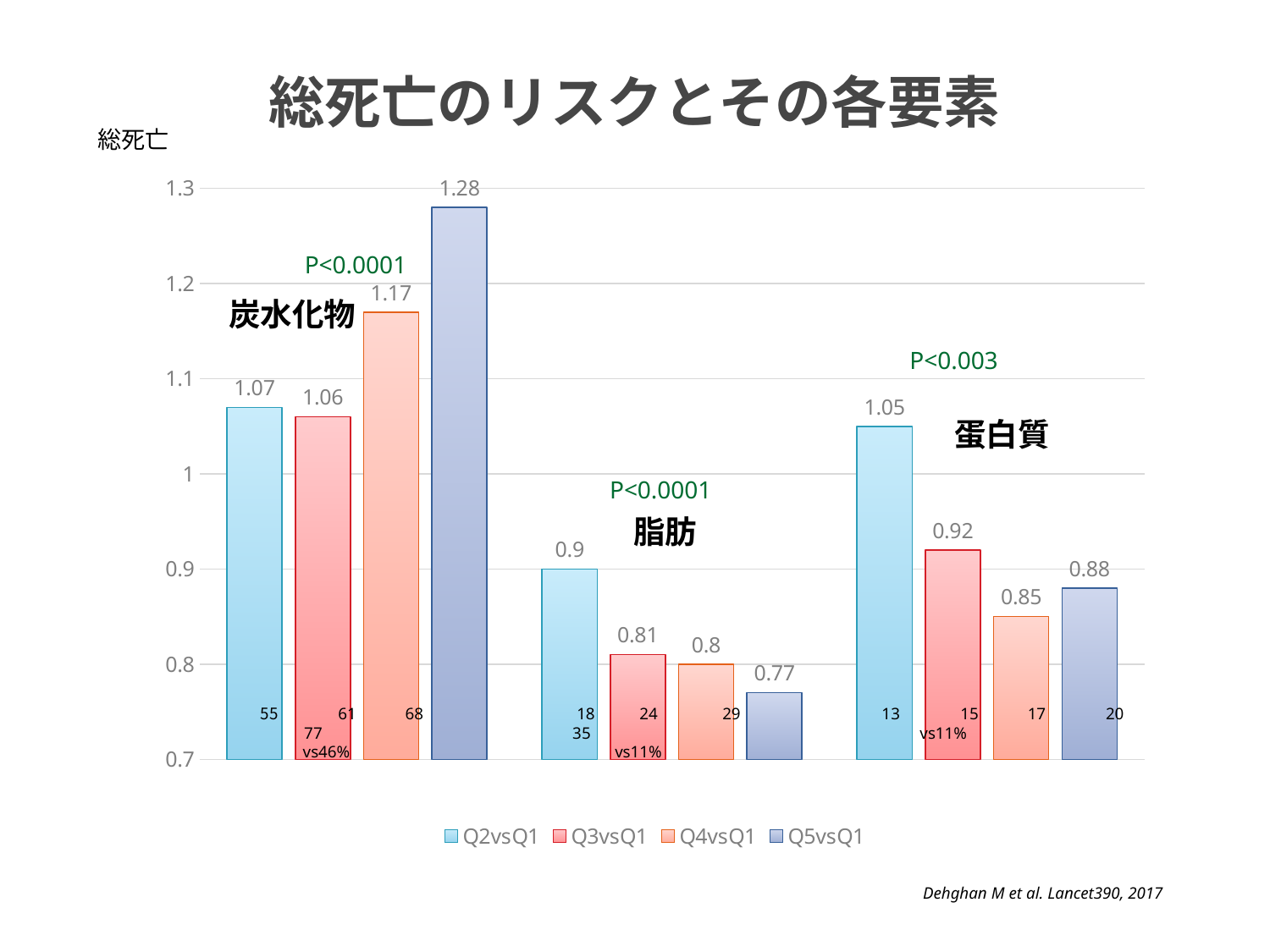
What kind of chart is shown on the slide? bar chart Is the Q4vsQ1 value for 炭水化物 greater or less than 1.1? greater What is the value of the Q2vsQ1 bar for 脂肪? 0.9 What P value is shown above the 蛋白質 group? P<0.003 How many series does the legend list? 4 What is the difference between the Q5vsQ1 and Q2vsQ1 values for 炭水化物? 0.21 Which group has the highest bar in the chart? 炭水化物 Do the values in the 脂肪 group rise or fall from Q2vsQ1 to Q5vsQ1? fall What is the value of the Q5vsQ1 bar for 炭水化物? 1.28 Which is larger: the Q4vsQ1 value for 蛋白質 or the Q5vsQ1 value for 蛋白質? Q5vsQ1 What is the value of the Q3vsQ1 bar for 蛋白質? 0.92 Which series has the lowest value in the 脂肪 group? Q5vsQ1